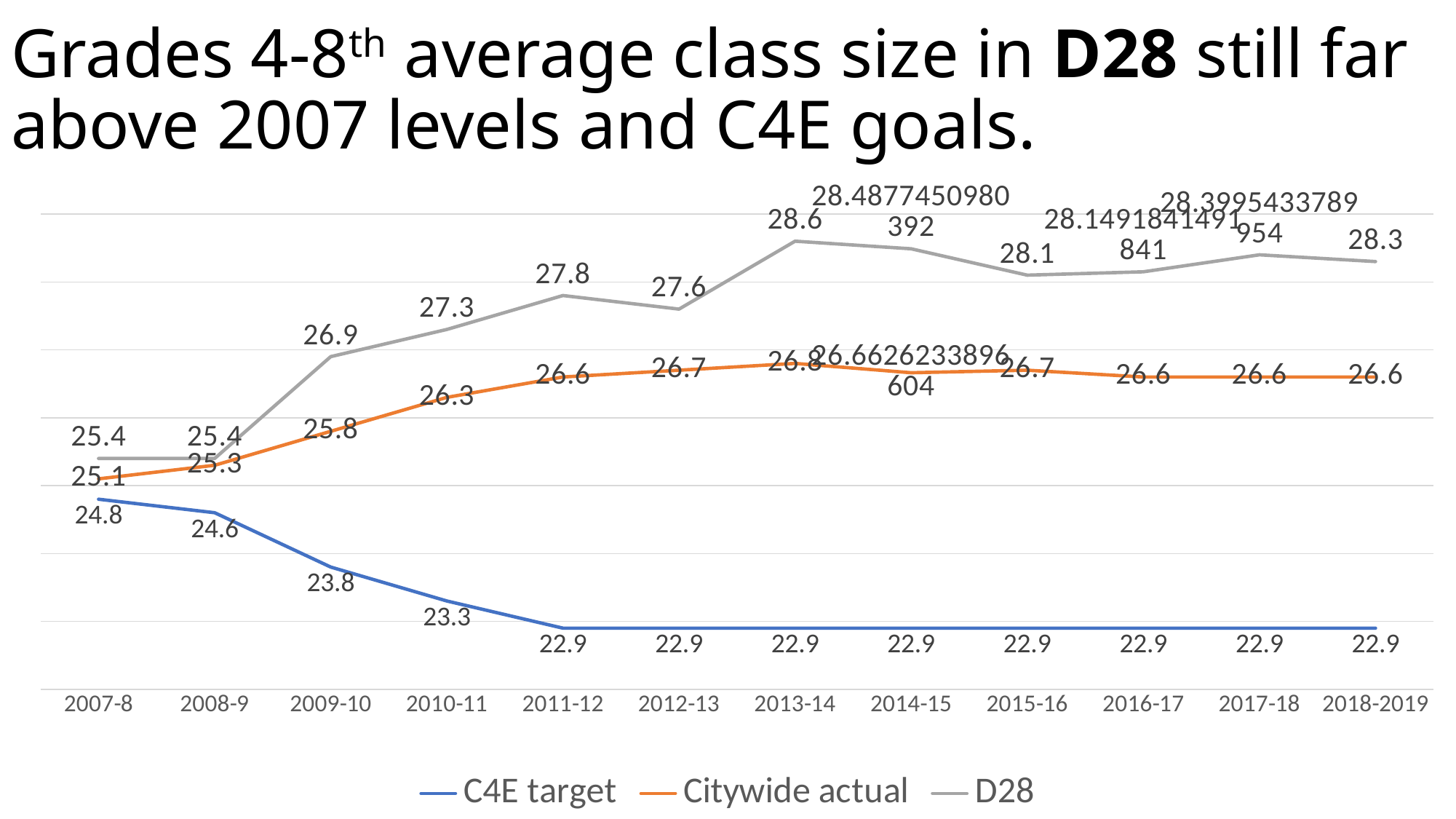
How many school years are plotted along the x axis? 12 What is the C4E target value for 2009-10? 23.8 In 2007-8, which is larger: the D28 value or the Citywide actual value? D28 In which school year is the Citywide actual value lowest? 2007-8 What is the difference between the D28 value and the Citywide actual value in 2018-2019? 1.7 Does the C4E target rise or fall from 2007-8 to 2011-12? fall What kind of chart is shown on the slide? line chart In which school year is the D28 value highest? 2013-14 What colour is the D28 line in the legend? grey What is the D28 value for 2013-14? 28.6 How many series does the legend list? 3 What is the Citywide actual value for 2011-12? 26.6